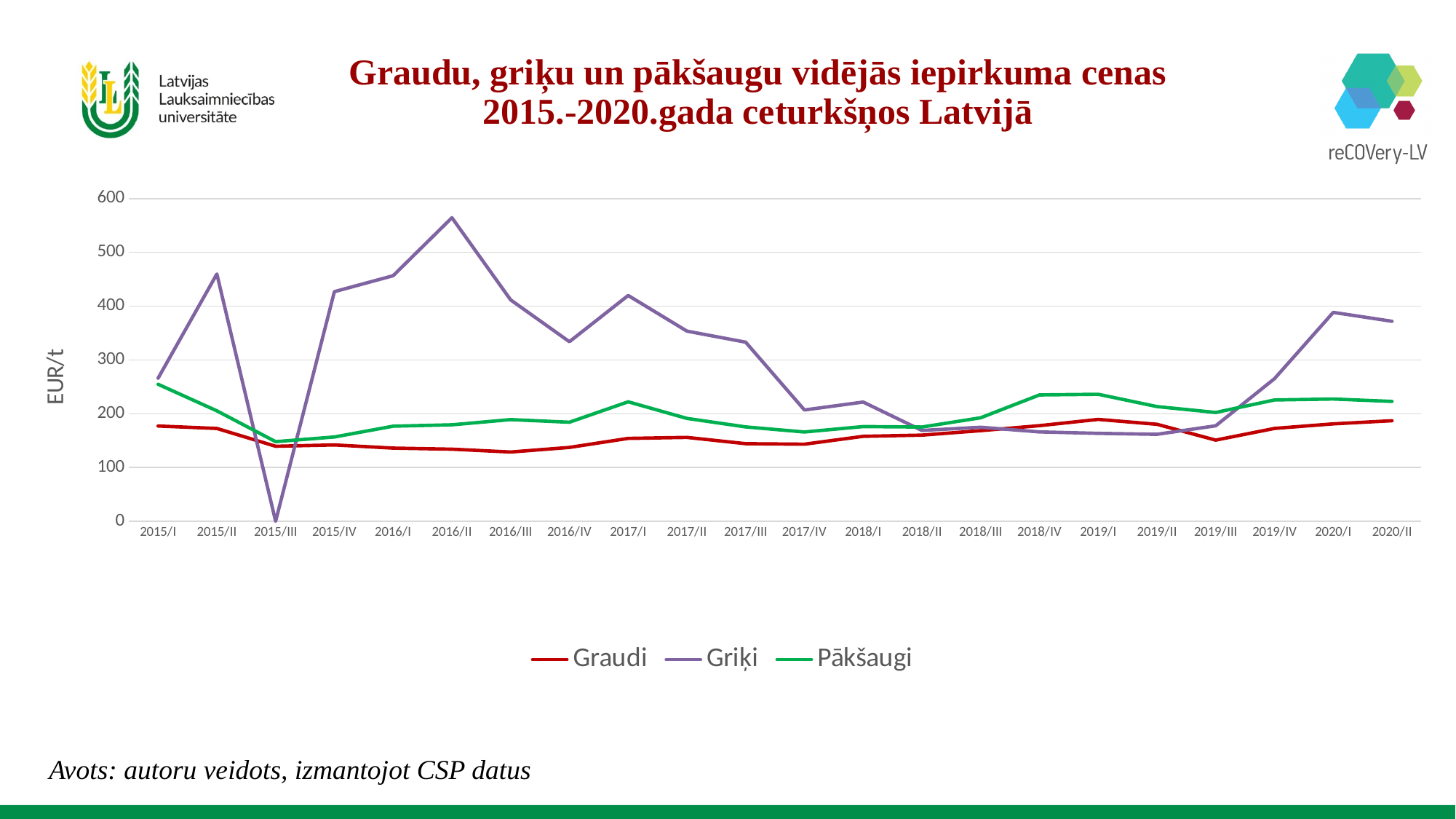
Does the Griķi series rise or fall from 2019/II to 2020/I? rise Is the value for Griķi in 2016/II greater or less than 500? greater Is the value for Pākšaugi in 2015/I greater or less than 200? greater How many series does the legend list? 3 How many quarters are plotted along the x axis? 22 Which series has the larger value in 2019/III, Pākšaugi or Graudi? Pākšaugi Is the value for Griķi in 2017/IV greater or less than 300? less What kind of chart is shown on the slide? line chart What is the label on the y axis? EUR/t In which quarter does the Griķi series reach its highest value? 2016/II In which quarter does the Griķi series reach its lowest value? 2015/III